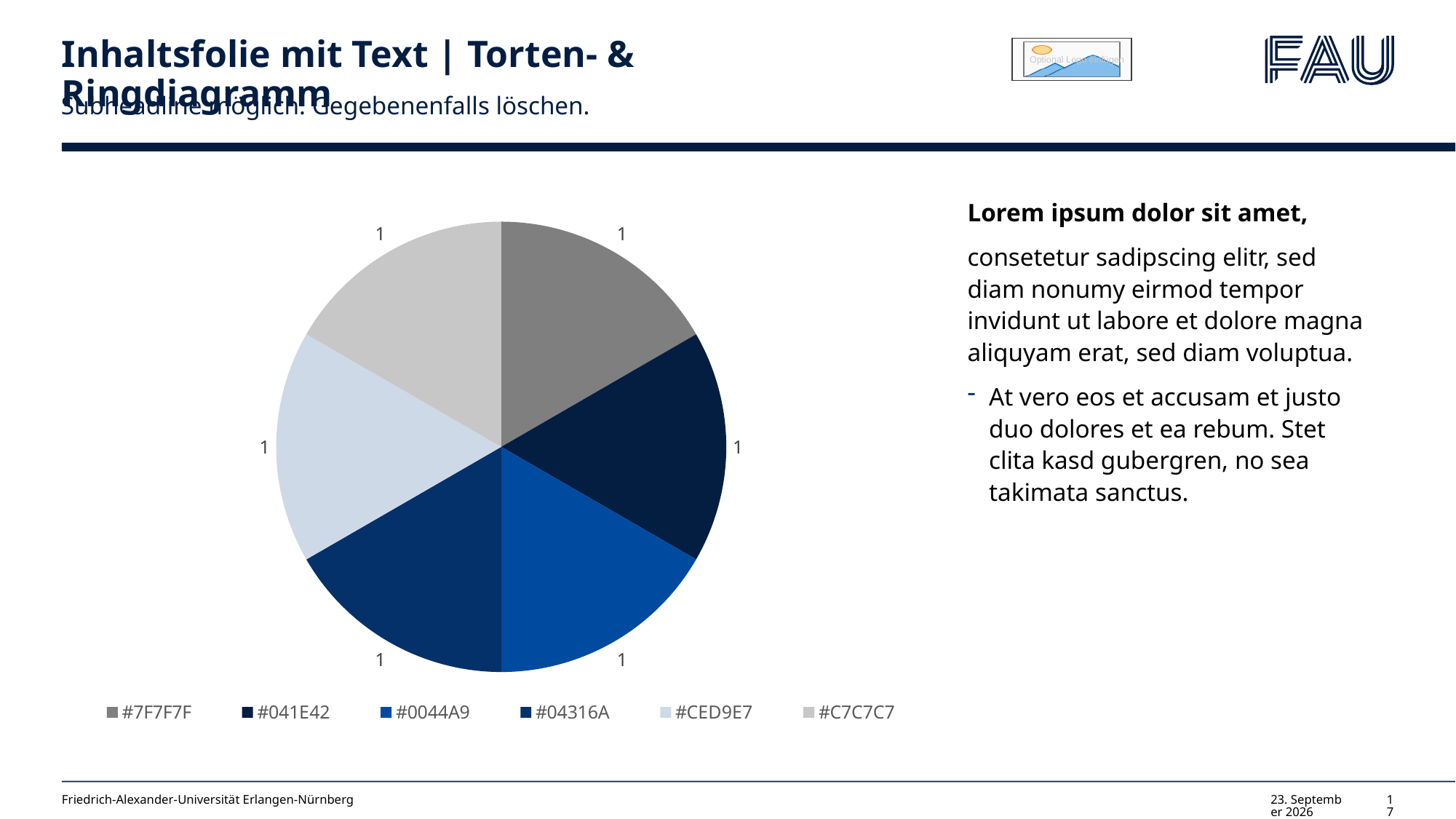
What is the total of all slice values in the pie chart? 6 How many entries does the legend of the pie chart list? 6 How many slices does the pie chart have? 6 What share of the pie does the #041E42 slice represent? 1/6 Which legend entry is listed first in the pie chart's legend? #7F7F7F Do all slices of the pie chart have the same value? Yes What is the value of the #CED9E7 slice in the pie chart? 1 What is the value of the #0044A9 slice in the pie chart? 1 What kind of chart is shown on the slide? pie chart What is the value of the #7F7F7F slice in the pie chart? 1 What is the value of the #C7C7C7 slice in the pie chart? 1 What is the difference between the values of the #041E42 and #04316A slices? 0